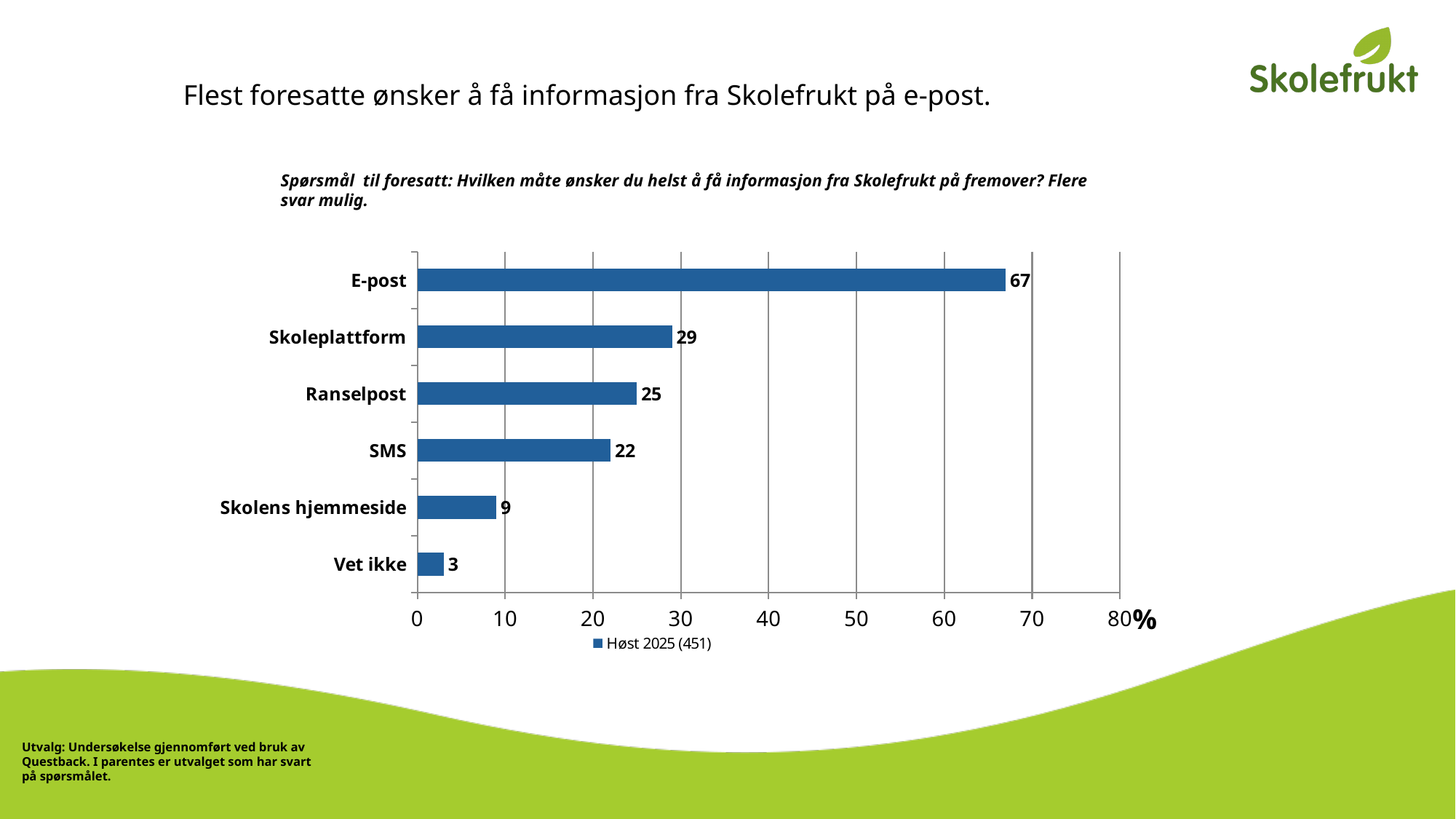
What is the value for E-post? 67 Which category has the lowest value? Vet ikke What kind of chart is shown on the slide? Bar chart What is the difference between the values for E-post and Skoleplattform? 38 What is the legend entry for the series shown in the chart? Høst 2025 (451) Is the value for E-post greater or less than 60? greater Which is larger, the value for Ranselpost or the value for SMS? Ranselpost What is the value for Skolens hjemmeside? 9 What is the difference between the values for Ranselpost and SMS? 3 Which category has the highest value? E-post What is the value for Skoleplattform? 29 How many categories are shown in the chart? 6